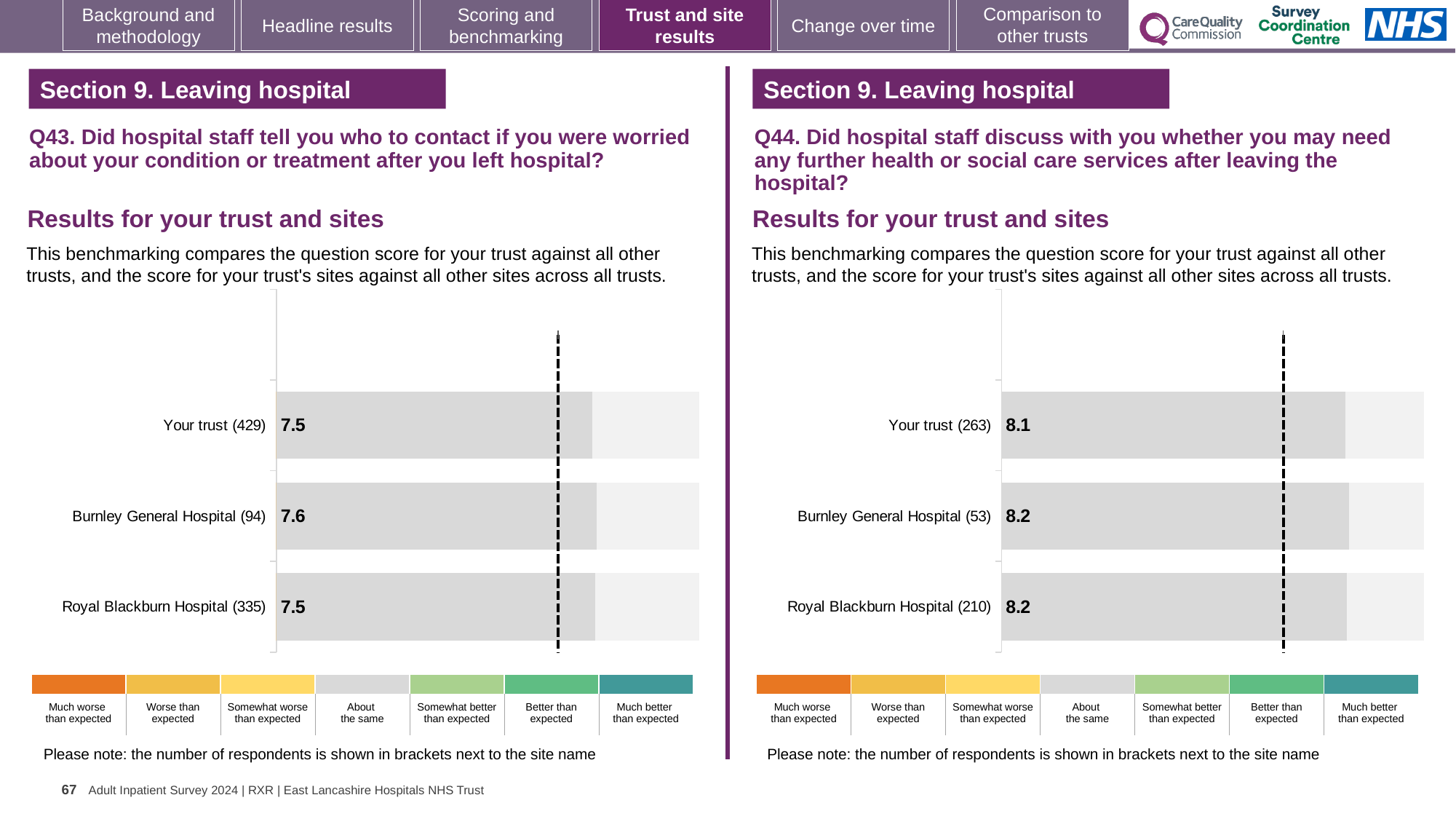
In the Q43 chart on the left, what is the score for Your trust? 7.5 What kind of chart is the Q44 chart on the right? Bar chart In the Q43 chart on the left, what is the difference between the scores for Burnley General Hospital and Your trust? 0.1 In the Q44 chart on the right, how many respondents are shown in brackets for Burnley General Hospital? 53 In the Q44 chart on the right, which has the larger score: Burnley General Hospital or Your trust? Burnley General Hospital In the Q44 chart on the right, which category has the lowest score? Your trust How many categories are shown in the Q43 chart on the left? 3 In the Q43 chart on the left, what is the score for Burnley General Hospital? 7.6 In the Q44 chart on the right, what is the score for Your trust? 8.1 In the Q43 chart on the left, how many respondents are shown in brackets for Royal Blackburn Hospital? 335 In the Q43 chart on the left, which category has the highest score? Burnley General Hospital In the Q44 chart on the right, what is the score for Royal Blackburn Hospital? 8.2